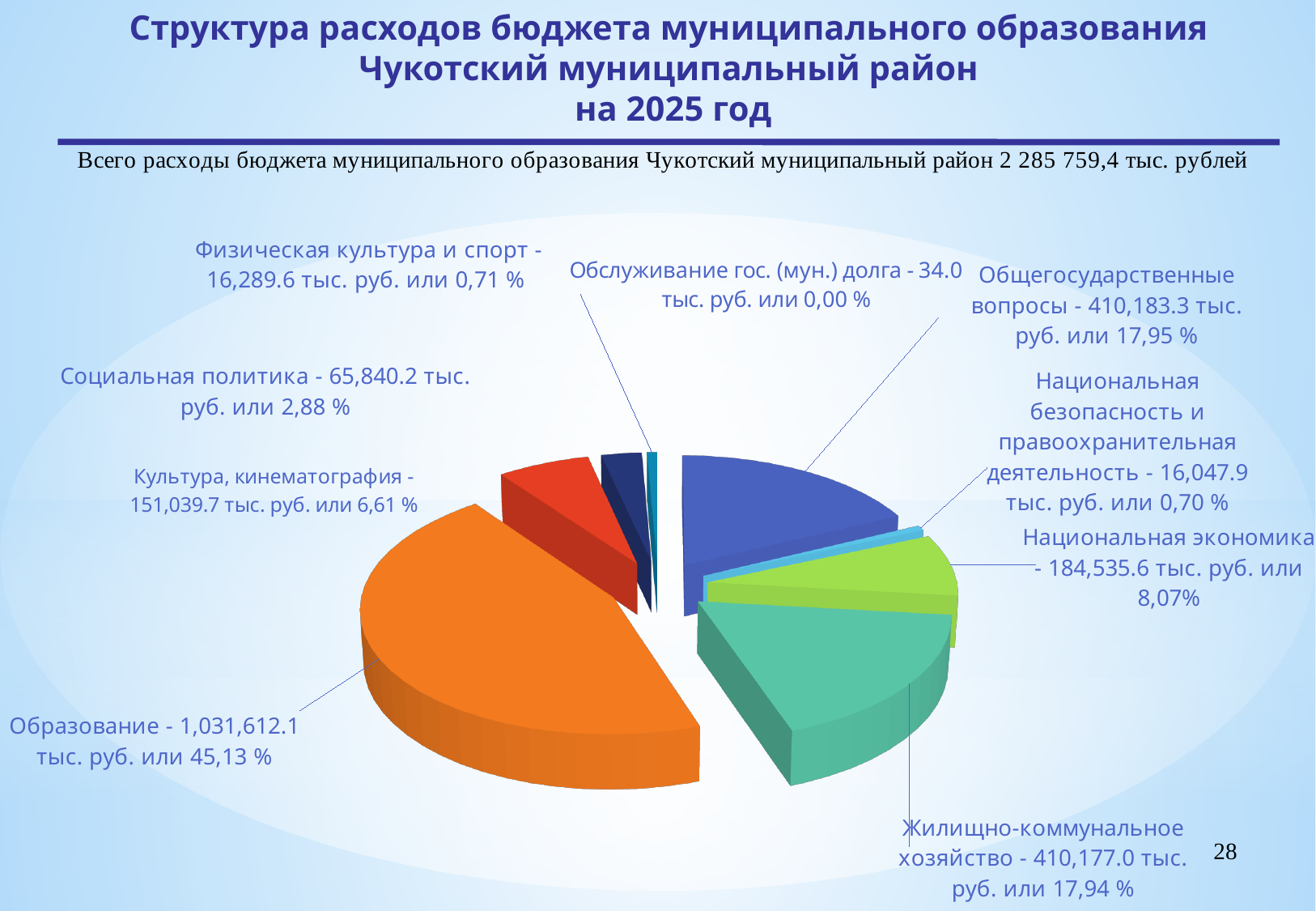
What total budget expenditure amount is stated on the slide? 2 285 759,4 тыс. рублей What is the value for Жилищно-коммунальное хозяйство? 410,177.0 тыс. руб. What share of the budget expenditures does Национальная экономика account for? 8,07% What kind of chart is shown on the slide? Pie chart Which category has the largest share of expenditures? Образование How many expenditure categories are shown in the pie chart? 9 Which category has the smallest share of expenditures? Обслуживание гос. (мун.) долга What is the difference in тыс. руб. between Национальная экономика and Культура, кинематография? 33,495.9 тыс. руб. What share of expenditures does Социальная политика account for? 2,88 % What is the difference in тыс. руб. between Общегосударственные вопросы and Жилищно-коммунальное хозяйство? 6.3 тыс. руб. What is the value for Образование? 1,031,612.1 тыс. руб. Which is larger: Физическая культура и спорт or Национальная безопасность и правоохранительная деятельность? Физическая культура и спорт